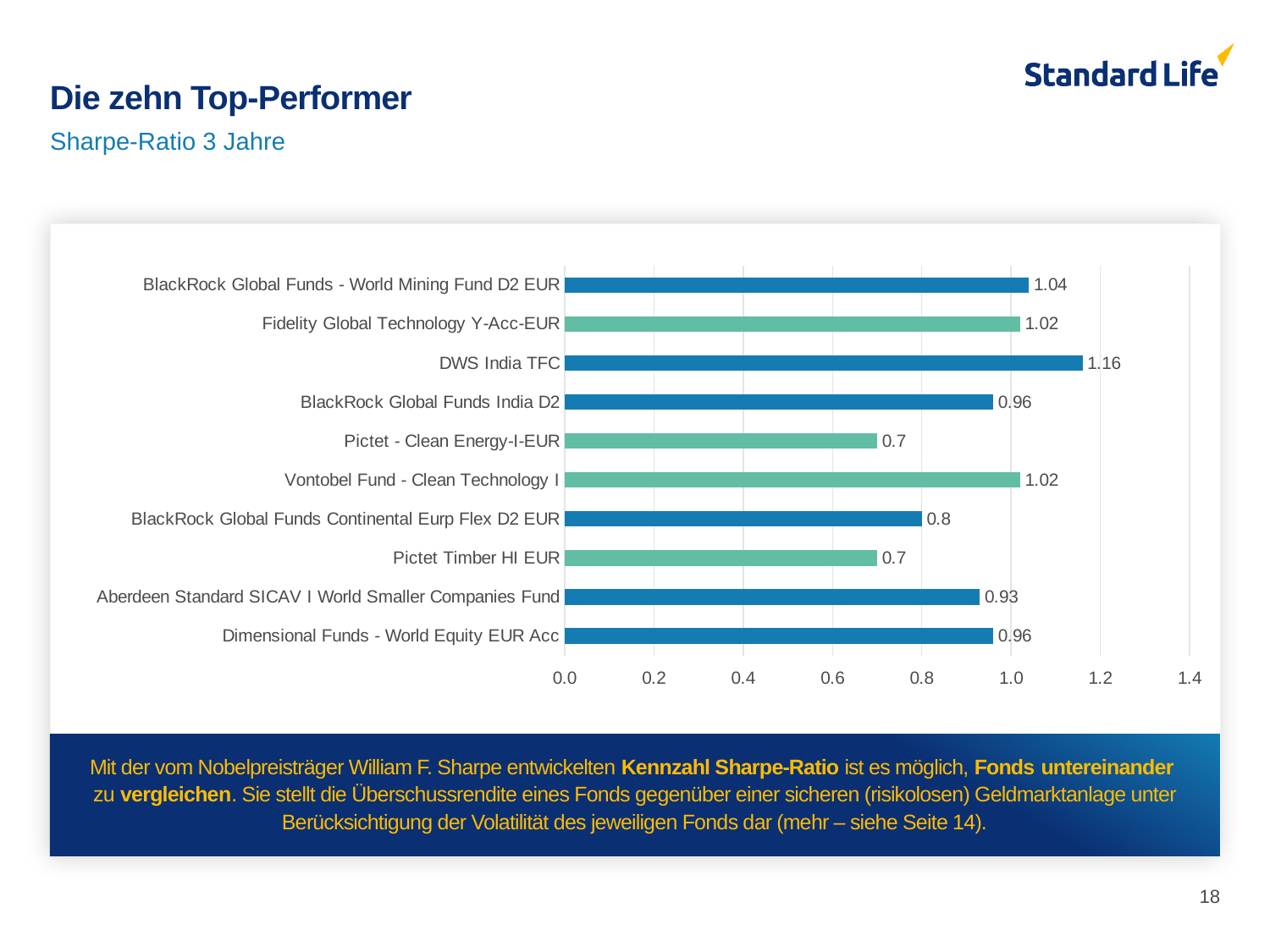
What value is shown for Aberdeen Standard SICAV I World Smaller Companies Fund? 0.93 What is the difference between the values for DWS India TFC and BlackRock Global Funds - World Mining Fund D2 EUR? 0.12 Is the value for Dimensional Funds - World Equity EUR Acc greater or less than 1.0? less What is the Sharpe ratio shown for DWS India TFC? 1.16 What value is shown for Pictet - Clean Energy-I-EUR? 0.7 What value is shown for BlackRock Global Funds Continental Eurp Flex D2 EUR? 0.8 What is the subtitle of the slide describing the metric plotted? Sharpe-Ratio 3 Jahre What is the difference between the values for Fidelity Global Technology Y-Acc-EUR and Pictet Timber HI EUR? 0.32 What type of chart is shown on the slide? bar chart Which has a larger value: BlackRock Global Funds India D2 or Aberdeen Standard SICAV I World Smaller Companies Fund? BlackRock Global Funds India D2 Which fund has the highest Sharpe ratio in the chart? DWS India TFC How many funds are shown in the chart? 10